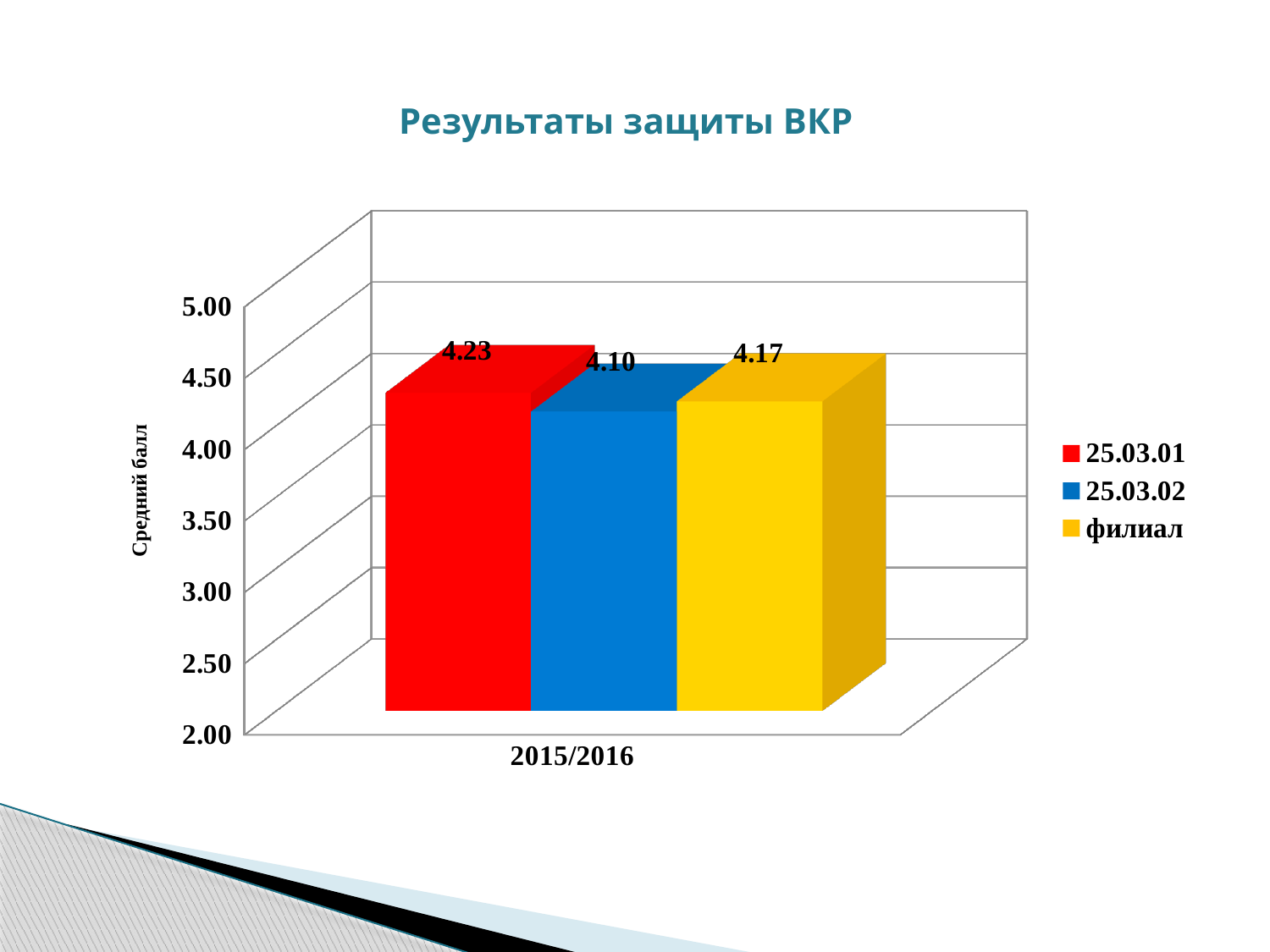
What is the value for 25.03.02 in 2015/2016? 4.10 How many series does the legend list? 3 Is the value for 25.03.02 greater or less than 4.00? greater What is the difference between the values for филиал and 25.03.02? 0.07 What kind of chart is shown on the slide? bar chart What is the value for 25.03.01 in 2015/2016? 4.23 Which series has the highest value? 25.03.01 What is the title of the chart? Результаты защиты ВКР What is the value for филиал in 2015/2016? 4.17 What is the difference between the values for 25.03.01 and 25.03.02? 0.13 Which series has the lowest value? 25.03.02 Which is larger, the value for 25.03.01 or the value for филиал? 25.03.01